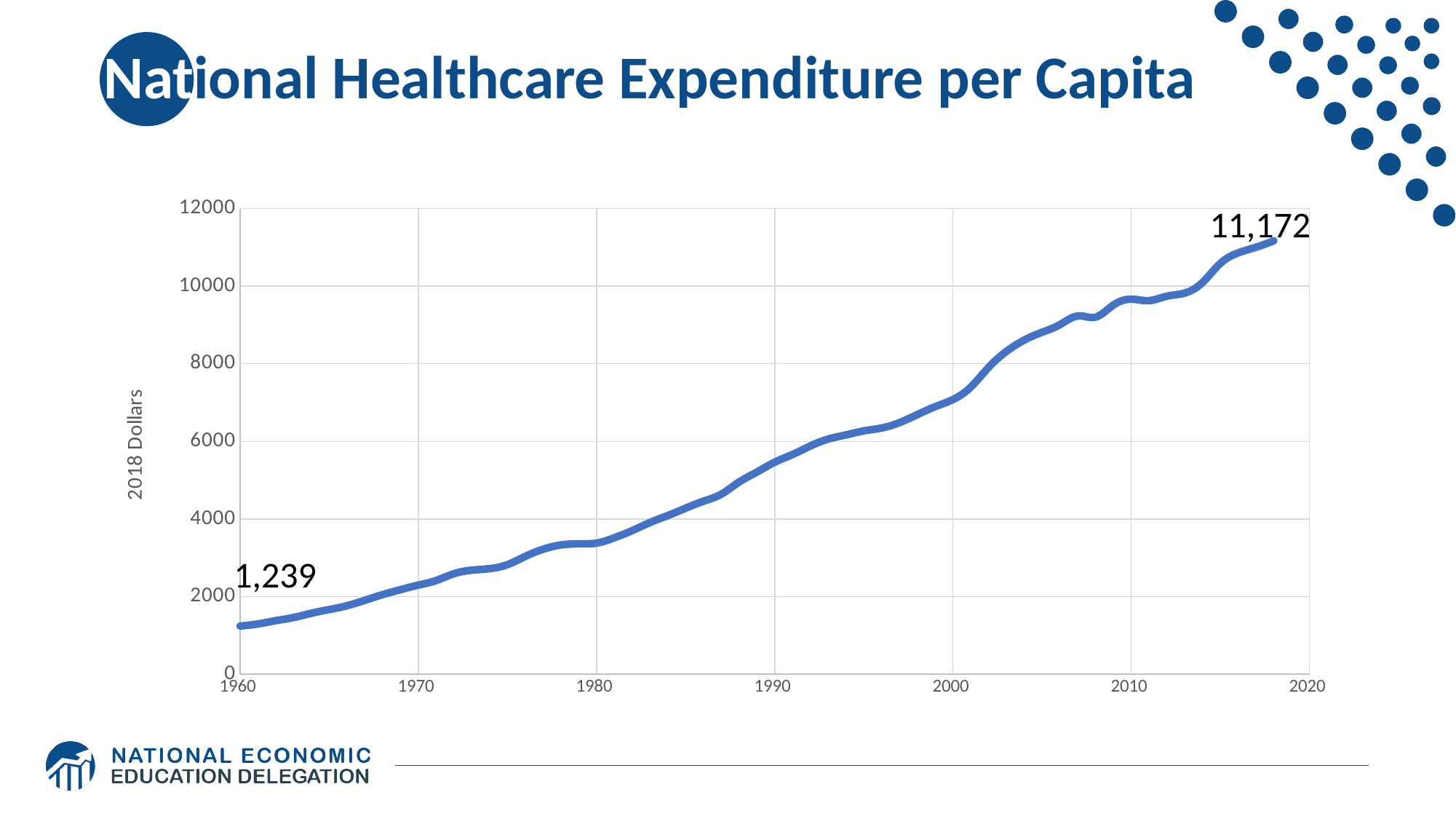
Is the value for 2010 greater or less than 10000? less What is the label on the vertical axis of the chart? 2018 Dollars Is the value for 2010 greater or less than 8000? greater Which is larger, the labelled value in 1960 or the labelled value at the end of the line? The value at the end of the line What kind of chart is shown on the slide? line chart What is the value labelled at the last point of the line? 11,172 What is the difference between the labelled value at the end of the line (11,172) and the labelled value in 1960 (1,239)? 9,933 Is the value for 1980 greater or less than 4000? less Do the values rise or fall from 1960 to the end of the line? rise What is the value labelled at the start of the line, in 1960? 1,239